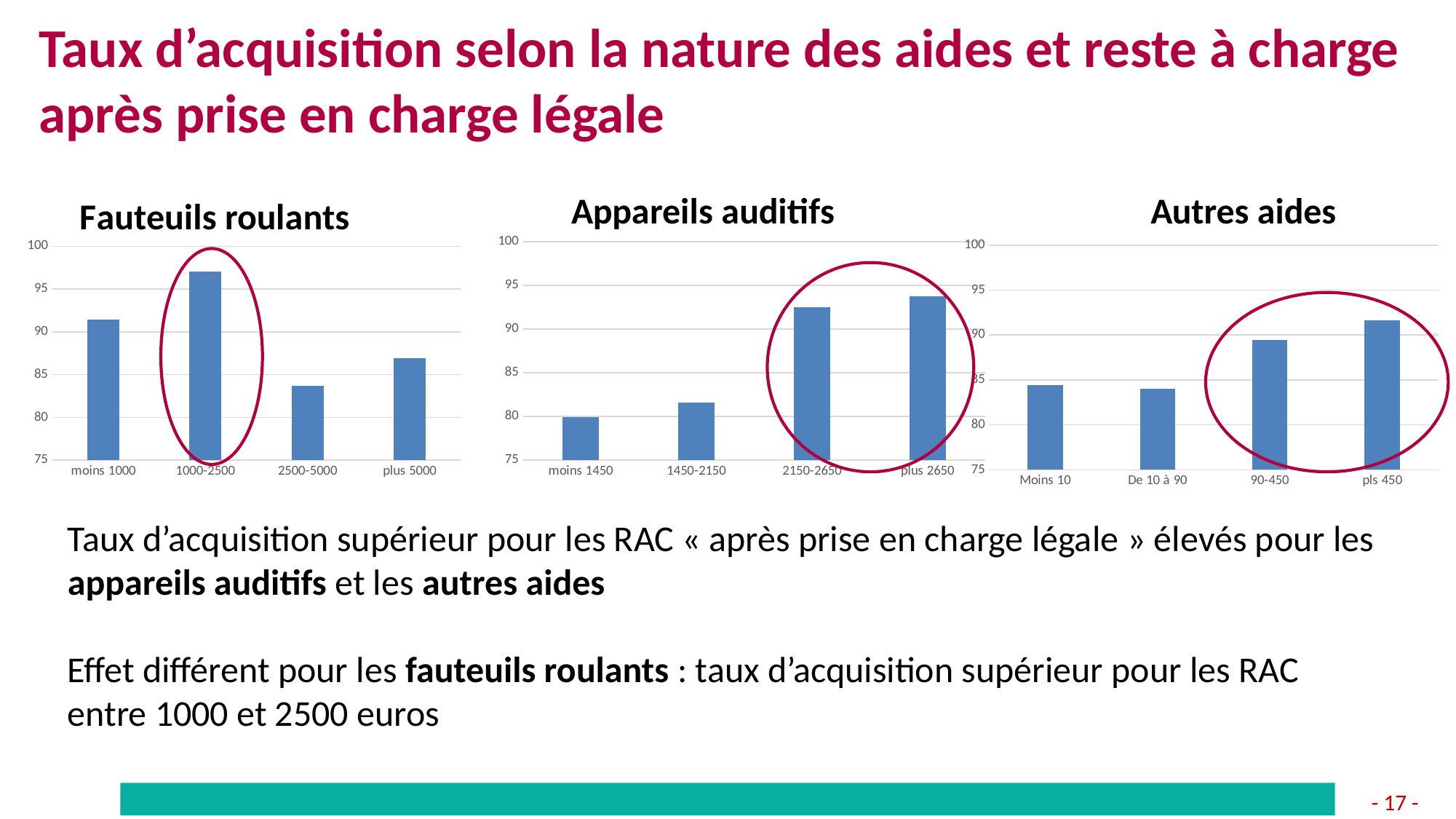
In the Fauteuils roulants chart, which category has the lowest acquisition rate? 2500-5000 In the Appareils auditifs chart, do the values generally rise or fall from left to right? rise In the Appareils auditifs chart, is the value for moins 1450 greater or less than 85? less In the Autres aides chart, which category has the highest acquisition rate? pls 450 In the Fauteuils roulants chart, which is larger: moins 1000 or plus 5000? moins 1000 What type of chart is the Appareils auditifs chart? bar chart In the Appareils auditifs chart, is the value for 2150-2650 greater or less than 90? greater In the Fauteuils roulants chart, which category has the highest acquisition rate? 1000-2500 In the Fauteuils roulants chart, is the value for 2500-5000 greater or less than 85? less How many categories are shown in the Autres aides chart? 4